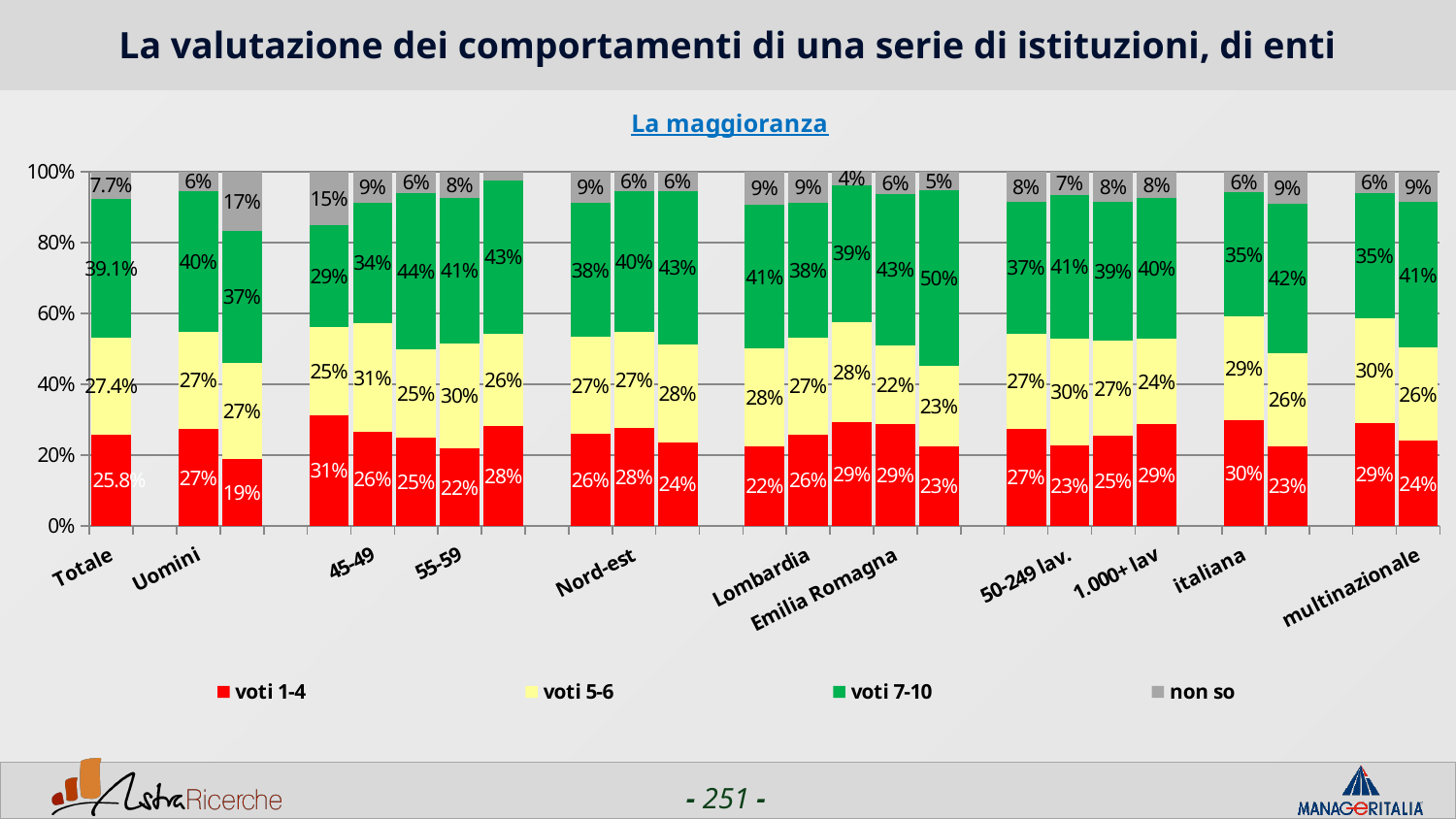
What kind of chart is shown on the slide? Stacked bar chart What are the four series listed in the legend? voti 1-4, voti 5-6, voti 7-10, non so What is the value of 'voti 7-10' for Totale? 39.1% What is the value of 'voti 1-4' for Totale? 25.8% Which series has the largest share in the Totale bar? voti 7-10 What is the value of 'voti 7-10' for Uomini? 40% How many series does the legend list? 4 What is the value of 'non so' for Totale? 7.7% What is the value of 'non so' for Uomini? 6% For Uomini, which is larger: 'voti 7-10' or 'voti 1-4'? voti 7-10 For Totale, what is the difference between 'voti 7-10' and 'voti 1-4'? 13.3 percentage points What is the value of 'voti 5-6' for Totale? 27.4%